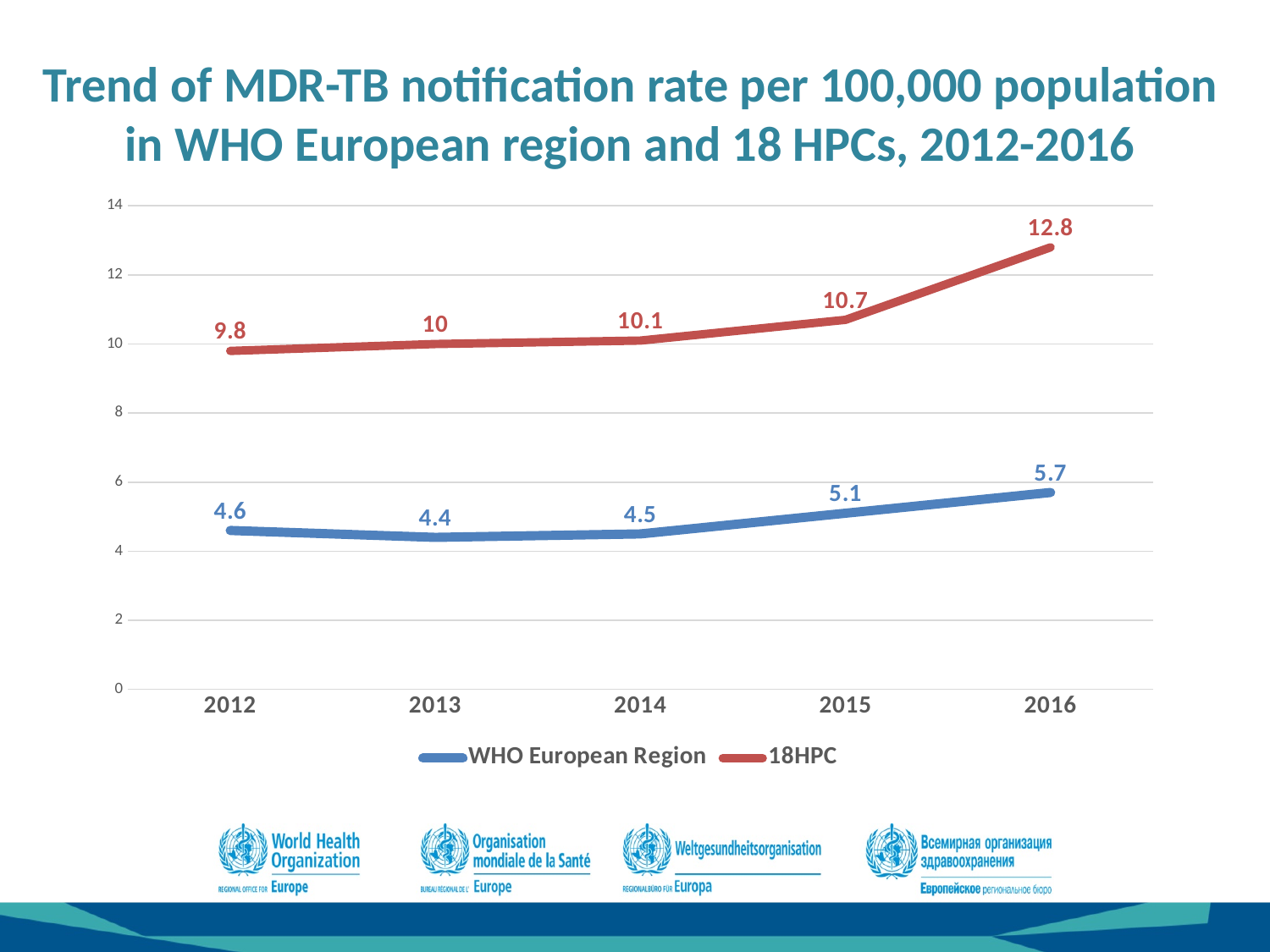
What is the difference between the 18HPC and WHO European Region values in 2016? 7.1 In which year is the 18HPC value highest? 2016 Which series has the higher value in 2014, WHO European Region or 18HPC? 18HPC What is the MDR-TB notification rate for the 18HPC series in 2016? 12.8 What is the value for the WHO European Region in 2013? 4.4 What kind of chart is shown on the slide? line chart By how much did the 18HPC value increase from 2015 to 2016? 2.1 In which year is the WHO European Region value lowest? 2013 Is the 18HPC value in 2016 greater or less than 12? greater How many series does the legend list? 2 How many years are shown on the x axis? 5 What is the value for the 18HPC series in 2012? 9.8